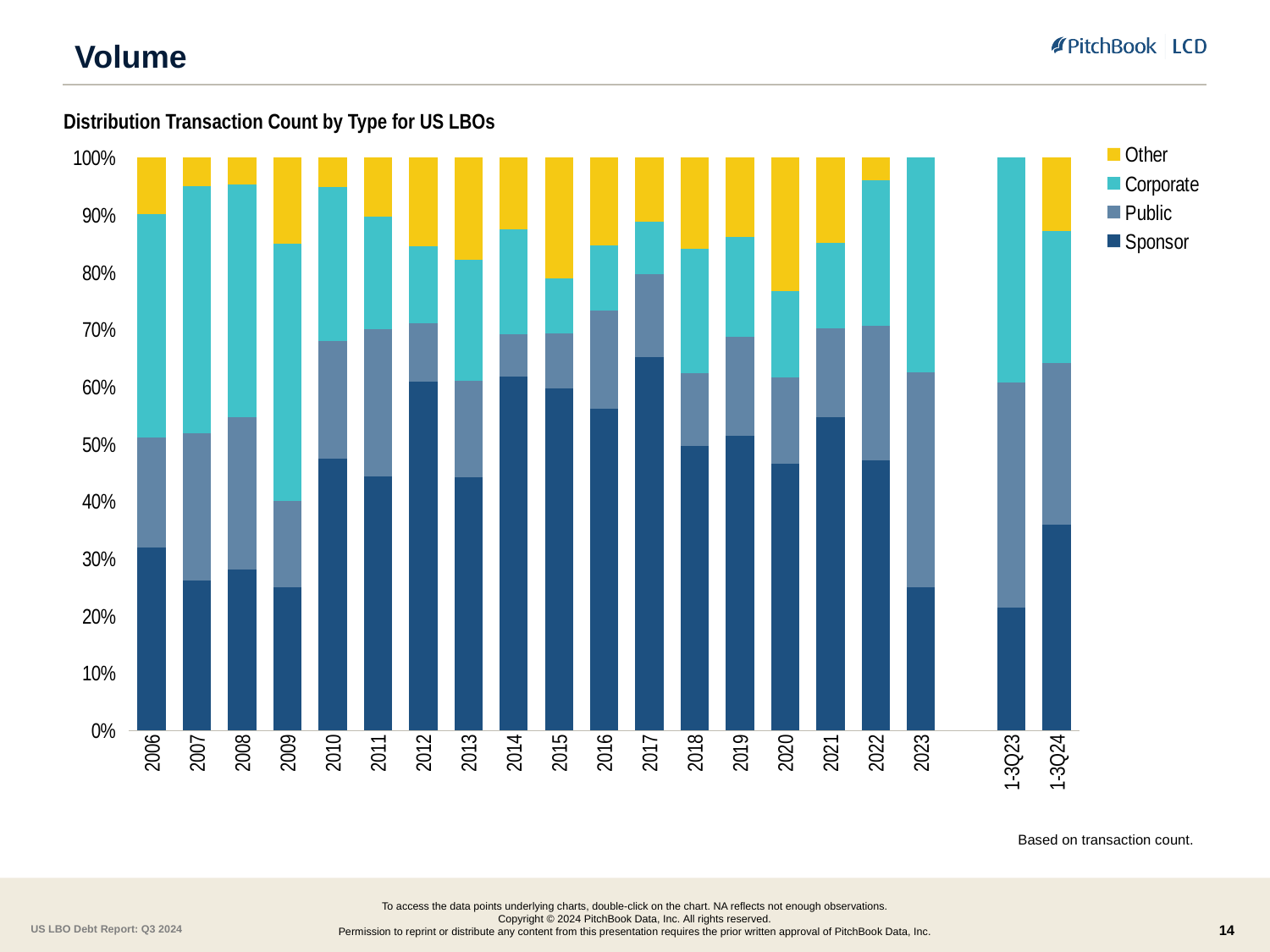
Which has the larger Sponsor share, 2017 or 2023? 2017 Is the Sponsor share for 1-3Q23 greater or less than 30%? less How many series does the legend list? 4 What is the title of the chart? Distribution Transaction Count by Type for US LBOs Which series is shown in yellow in the legend? Other Which category has the lowest Sponsor share? 1-3Q23 Which has the larger Sponsor share, 2012 or 2009? 2012 Is the Sponsor share for 2017 greater or less than 60%? greater How many categories are shown on the x axis? 20 Is the Sponsor share for 2006 greater or less than 30%? greater Which year has the highest Sponsor share? 2017 What kind of chart is shown on the slide? bar chart